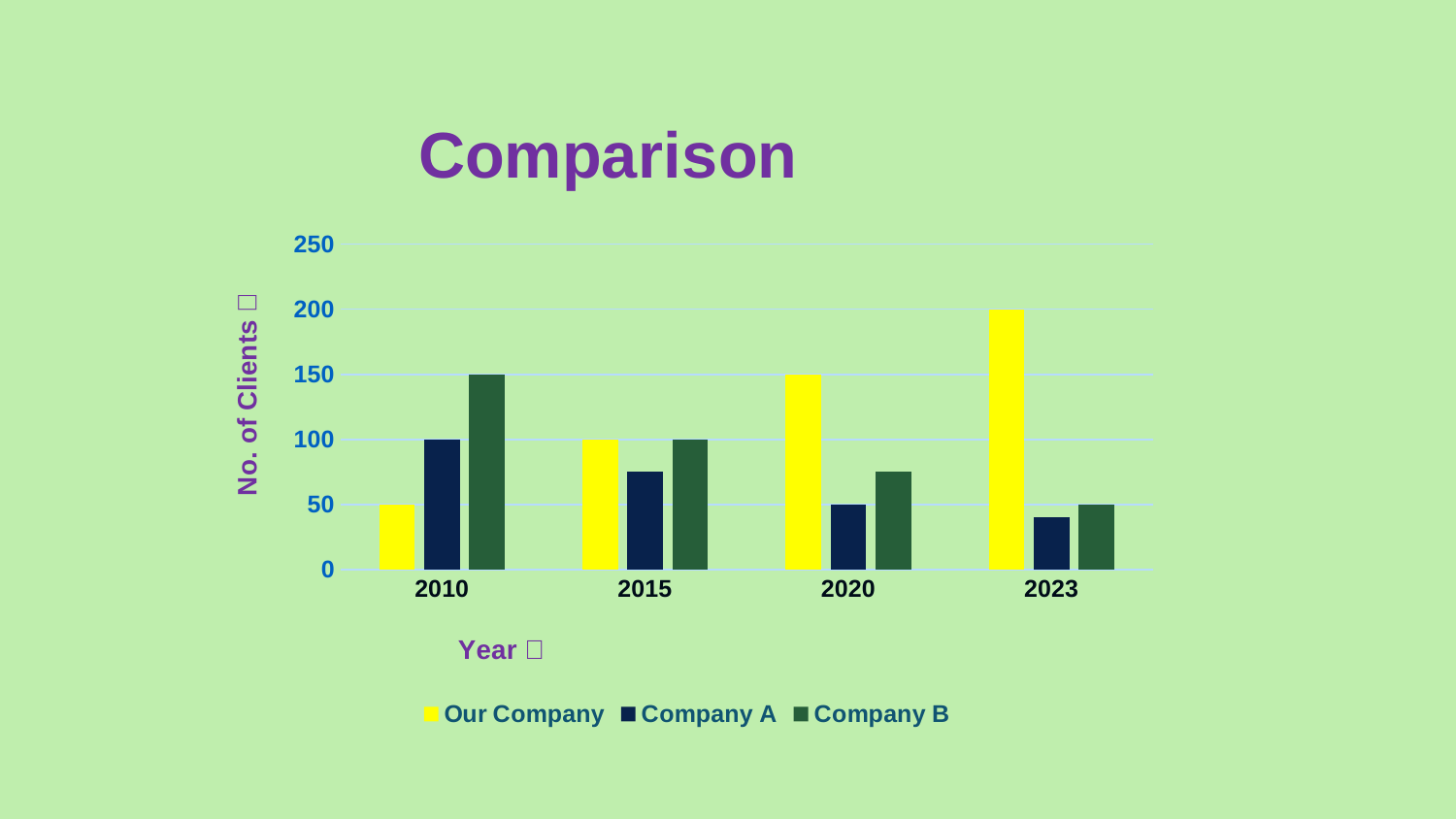
How many years are shown on the x axis? 4 What is the number of clients for Company B in 2010? 150 In which year does Our Company have the lowest number of clients? 2010 How many series does the legend list? 3 Is the value for Company A in 2023 greater or less than 50? less What is the number of clients for Our Company in 2023? 200 What is the difference between Our Company's clients in 2023 and in 2010? 150 What is the number of clients for Company A in 2010? 100 Do Our Company's values rise or fall from 2010 to 2023? rise In which year does Our Company have the highest number of clients? 2023 What kind of chart is shown on the slide? bar chart In 2020, which has more clients, Our Company or Company A? Our Company